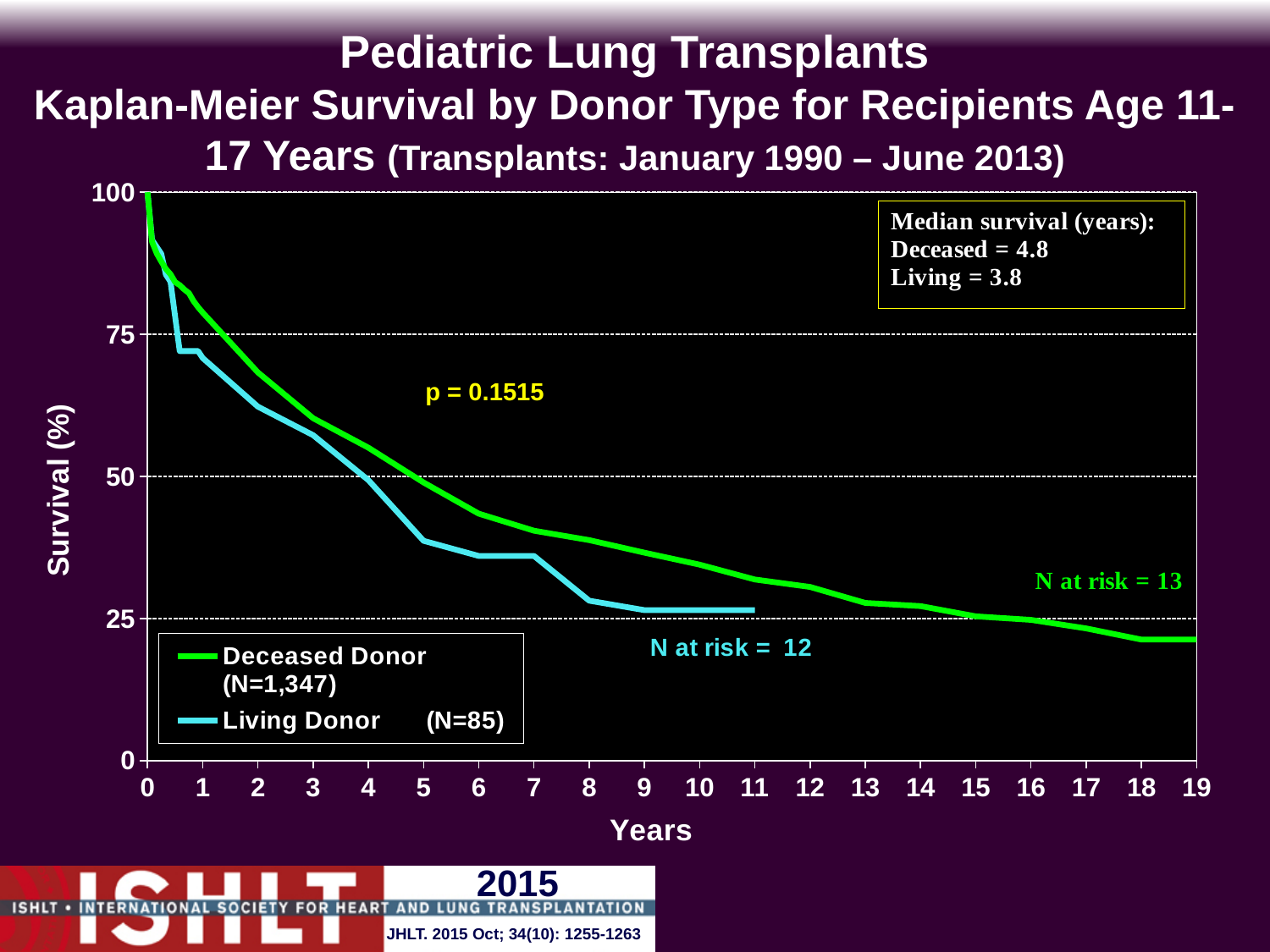
Is the survival value for Living Donor at year 5 greater or less than 50? less What is the difference in median survival (years) between the Deceased and Living donor groups? 1.0 Which donor group has the longer median survival, Deceased or Living? Deceased Is the survival value for Deceased Donor at year 10 greater or less than 25? greater What is the median survival in years for the Deceased donor group? 4.8 How many series does the legend list? 2 What is the median survival in years for the Living donor group? 3.8 What p-value is printed on the chart? p = 0.1515 Do the survival curves rise or fall as years increase along the x axis? fall What is the N for the Deceased Donor group shown in the legend? 1,347 What kind of chart is shown on the slide? line chart Is the survival value for Deceased Donor at year 1 greater or less than 75? greater